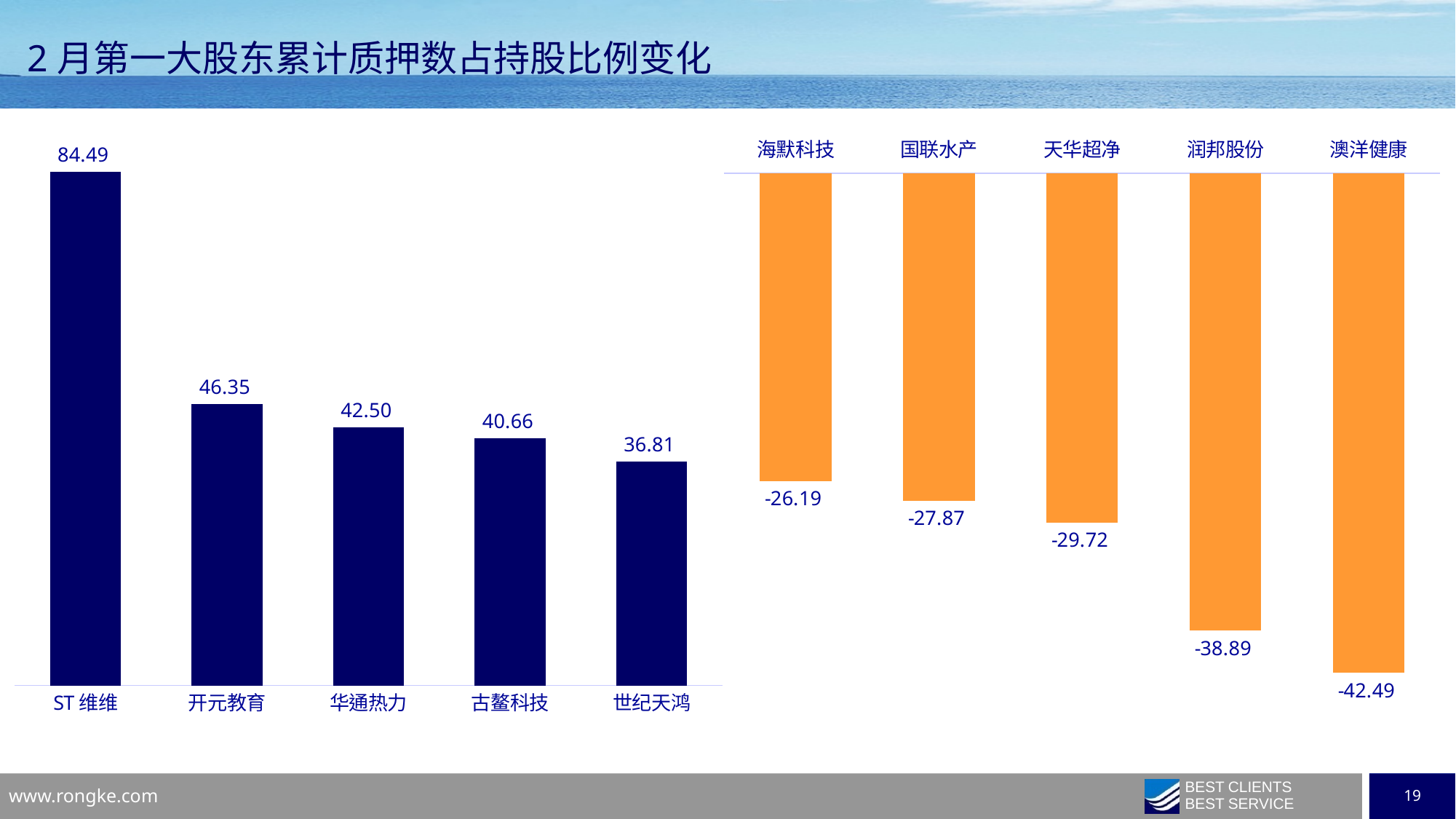
In the left chart, what is the value for ST 维维? 84.49 In the left chart, which category has the lowest value? 世纪天鸿 In the right chart, what is the value for 润邦股份? -38.89 In the right chart, what is the value for 海默科技? -26.19 What type of chart is the right chart? bar chart In the left chart, what is the difference between the values for ST 维维 and 开元教育? 38.14 In the right chart, what is the difference between the values for 澳洋健康 and 海默科技? 16.30 In the right chart, which category has the lowest value? 澳洋健康 In the left chart, what is the value for 华通热力? 42.50 In the left chart, do the values rise or fall from left to right? fall In the right chart, which is larger, the value for 国联水产 or the value for 天华超净? 国联水产 In the left chart, how many bars are plotted? 5